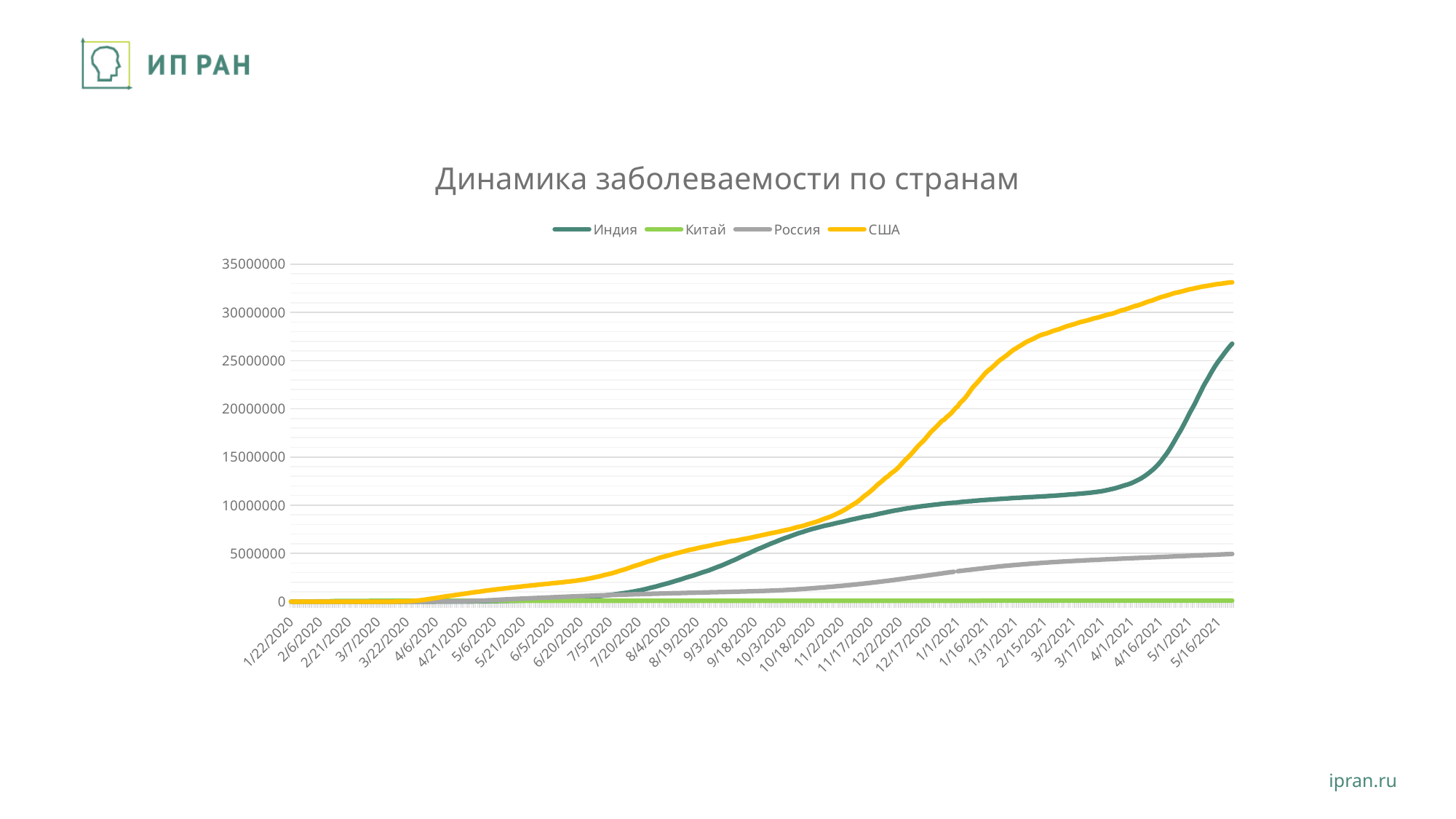
What kind of chart is shown on the slide? line chart Which series has the highest value at 5/16/2021? США Does the США line rise or fall from 1/22/2020 to 5/16/2021? rise How many series does the legend list? 4 Is the value for США at 2/15/2021 greater or less than 25000000? greater Is the value for Россия at 1/1/2021 greater or less than 5000000? less Is the value for США at 5/16/2021 greater or less than 30000000? greater Which series has the lowest value across the whole chart? Китай Which is larger at 1/1/2021, the value for Индия or the value for Россия? Индия Which countries are listed in the chart legend? Индия, Китай, Россия, США What is the title of the chart? Динамика заболеваемости по странам